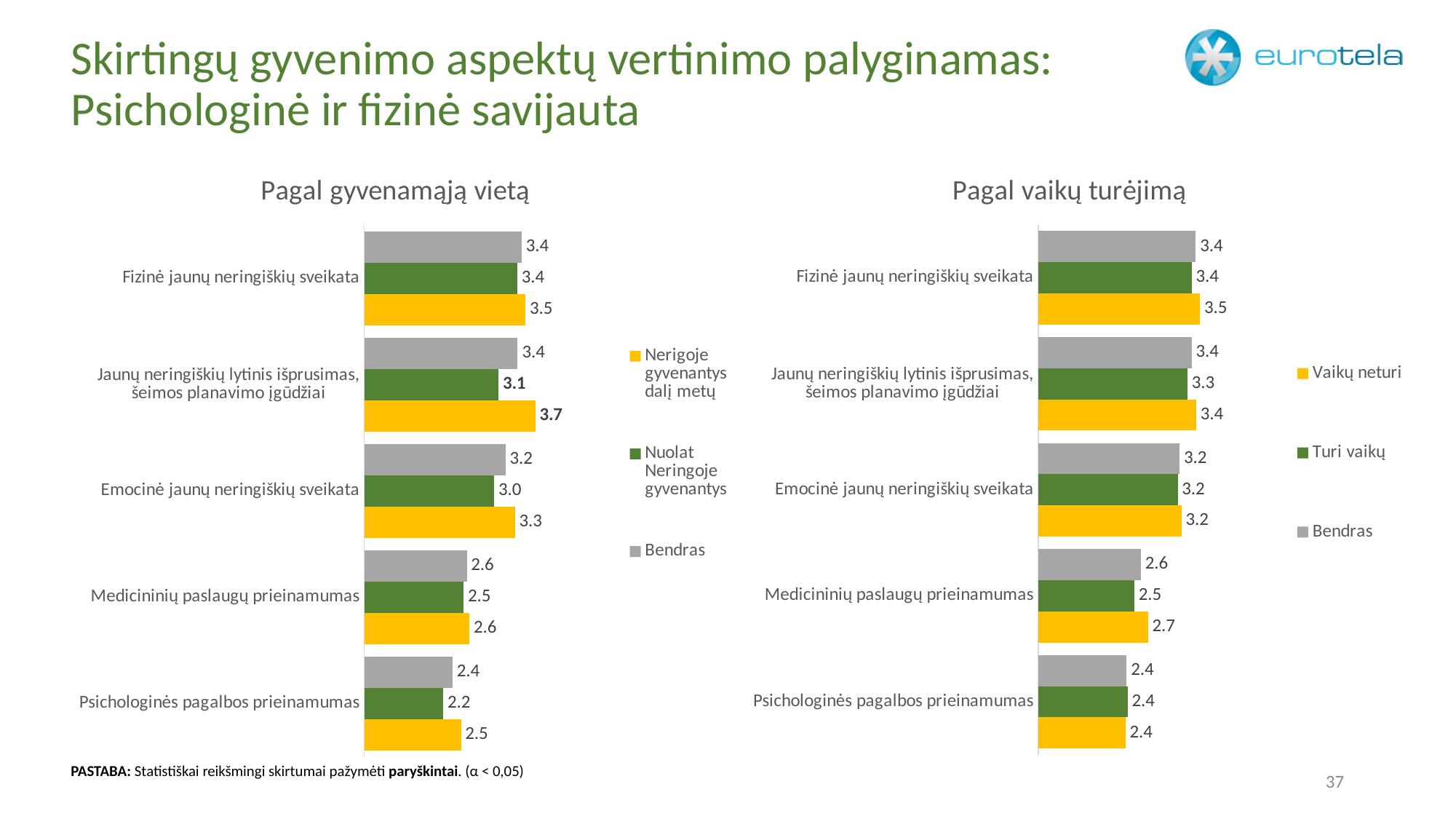
How many categories are shown in the 'Pagal vaikų turėjimą' chart? 5 In the 'Pagal gyvenamąją vietą' chart, what is the value for 'Nerigoje gyvenantys dalį metų' in the category 'Jaunų neringiškių lytinis išprusimas, šeimos planavimo įgūdžiai'? 3.7 In the 'Pagal gyvenamąją vietą' chart, which category has the highest value for 'Nerigoje gyvenantys dalį metų'? Jaunų neringiškių lytinis išprusimas, šeimos planavimo įgūdžiai How many series does the legend of the 'Pagal gyvenamąją vietą' chart list? 3 In the 'Pagal gyvenamąją vietą' chart, what is the value for 'Nuolat Neringoje gyvenantys' in the category 'Psichologinės pagalbos prieinamumas'? 2.2 In the 'Pagal vaikų turėjimą' chart, what is the value for 'Vaikų neturi' in the category 'Medicininių paslaugų prieinamumas'? 2.7 What type of chart is the 'Pagal vaikų turėjimą' chart? Bar chart In the 'Pagal gyvenamąją vietą' chart, which category has the lowest 'Bendras' value? Psichologinės pagalbos prieinamumas In the 'Pagal gyvenamąją vietą' chart, for 'Emocinė jaunų neringiškių sveikata', which is larger: the 'Nerigoje gyvenantys dalį metų' value or the 'Nuolat Neringoje gyvenantys' value? Nerigoje gyvenantys dalį metų In the 'Pagal vaikų turėjimą' chart, what is the 'Bendras' value for 'Emocinė jaunų neringiškių sveikata'? 3.2 In the 'Pagal gyvenamąją vietą' chart, what is the difference between the 'Nerigoje gyvenantys dalį metų' and 'Nuolat Neringoje gyvenantys' values for 'Jaunų neringiškių lytinis išprusimas, šeimos planavimo įgūdžiai'? 0.6 In the 'Pagal vaikų turėjimą' chart, what is the difference between the 'Vaikų neturi' and 'Turi vaikų' values for 'Medicininių paslaugų prieinamumas'? 0.2